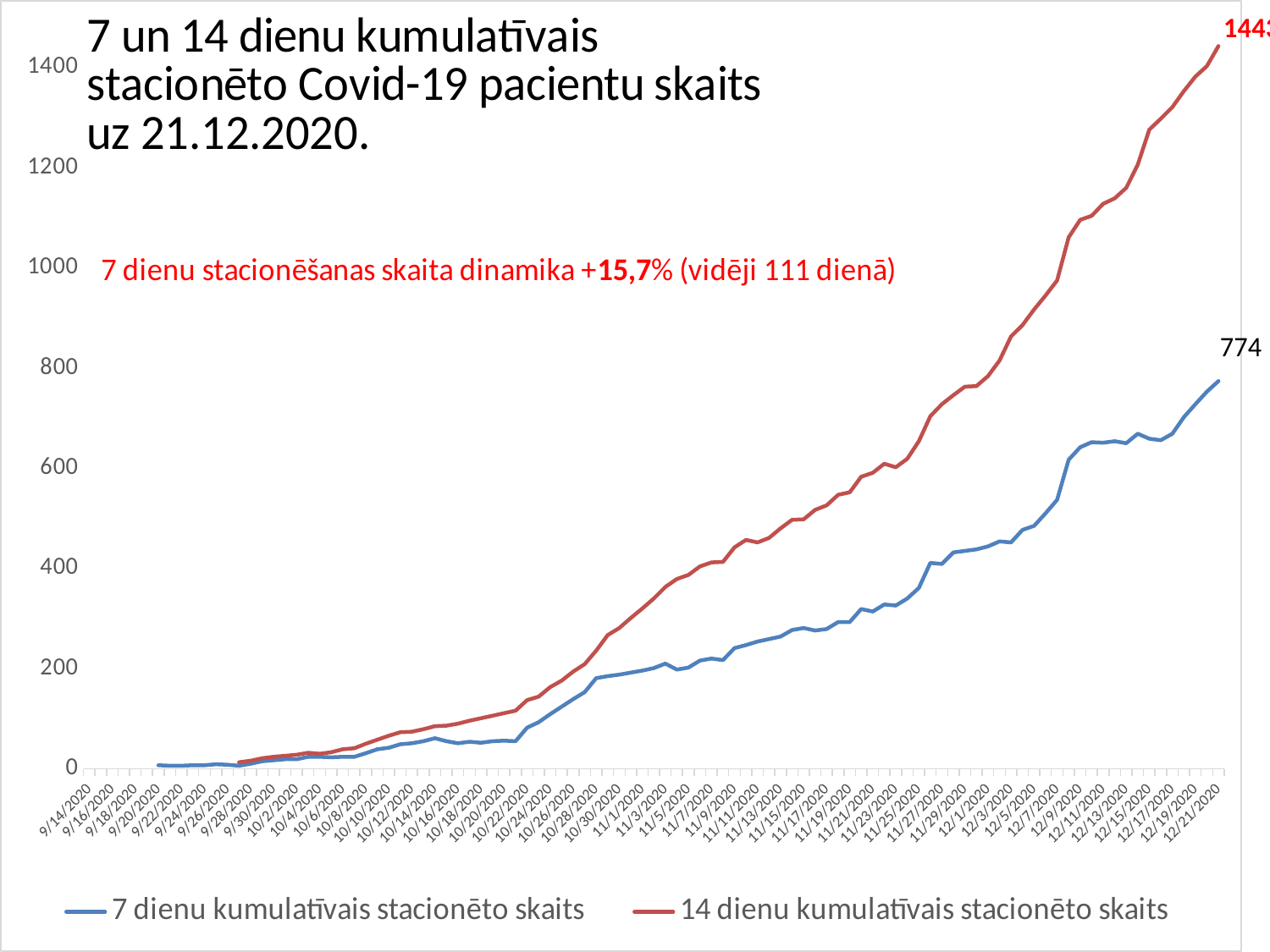
How many series does the legend list? 2 Do the values of the 14 dienu kumulatīvais stacionēto skaits series rise or fall along the x axis? rise What kind of chart is shown on the slide? line chart Is the value of the 7 dienu kumulatīvais stacionēto skaits series at 12/1/2020 greater or less than 600? less Is the value of the 14 dienu kumulatīvais stacionēto skaits series at 12/1/2020 greater or less than 600? greater What is the value of the 7 dienu kumulatīvais stacionēto skaits series at 12/21/2020? 774 Is the value of the 14 dienu kumulatīvais stacionēto skaits series at 12/21/2020 greater or less than 1400? greater What are the two series named in the legend? 7 dienu kumulatīvais stacionēto skaits; 14 dienu kumulatīvais stacionēto skaits Which series is higher at 12/21/2020, the 7 dienu or the 14 dienu kumulatīvais stacionēto skaits? 14 dienu kumulatīvais stacionēto skaits What colour is the line for the 7 dienu kumulatīvais stacionēto skaits series? blue